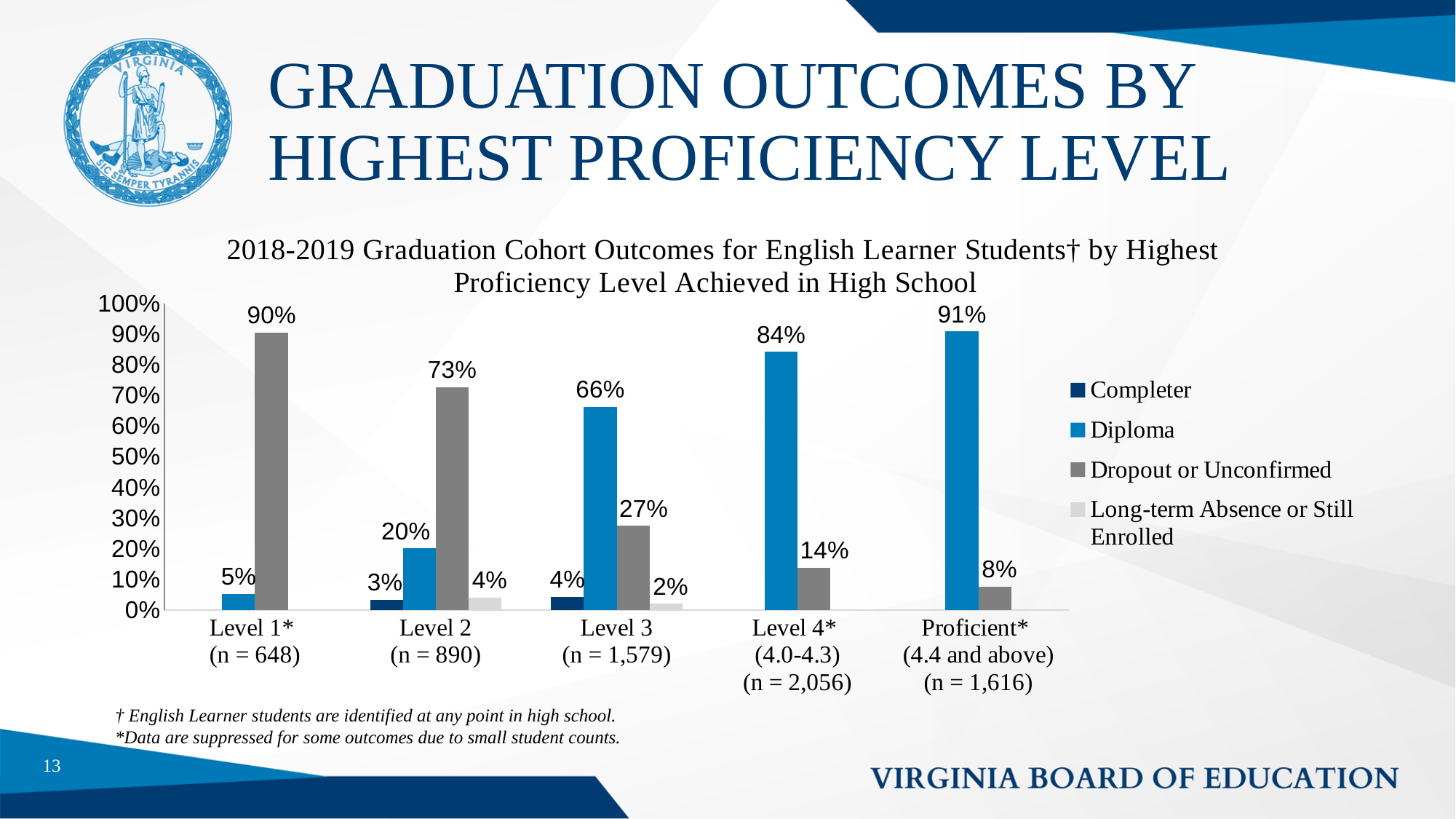
Which proficiency level has the highest Diploma percentage? Proficient* What is the Dropout or Unconfirmed percentage for Level 1*? 90% For Level 2, which is larger: the Diploma percentage or the Dropout or Unconfirmed percentage? Dropout or Unconfirmed What is the Long-term Absence or Still Enrolled percentage for Level 3? 2% What is the difference in Diploma percentage between Proficient* and Level 4*? 7 percentage points Does the Diploma percentage rise or fall as proficiency level increases from Level 1* to Proficient*? Rises How many proficiency level categories are shown on the x axis? 5 How many series does the legend list? 4 What is the Diploma percentage for Level 3? 66% What kind of chart is shown on the slide? Bar chart Which proficiency level has the lowest Dropout or Unconfirmed percentage? Proficient* What is the Completer percentage for Level 2? 3%